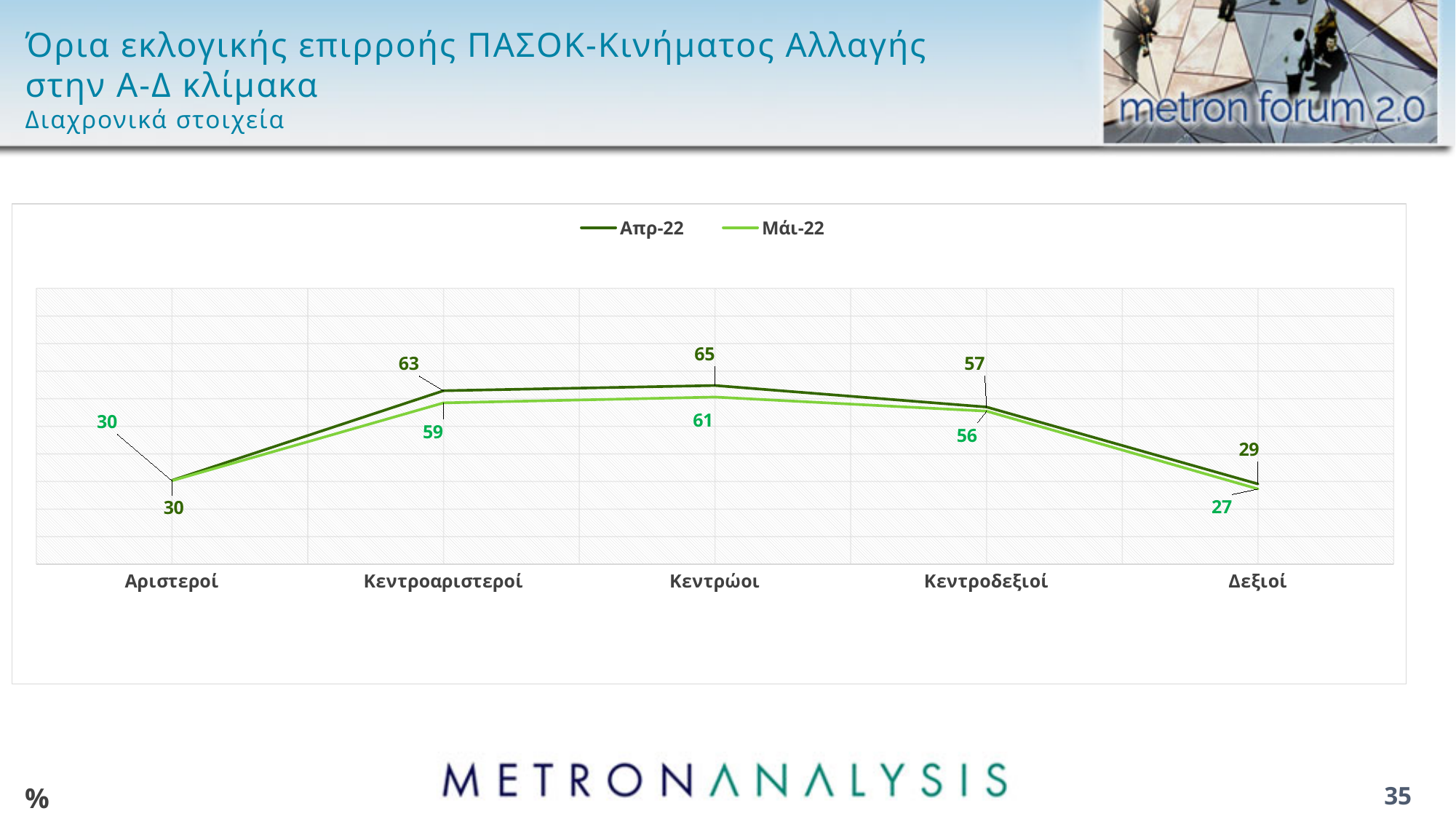
What is the difference between the Απρ-22 and Μάι-22 values for Κεντροαριστεροί? 4 How many categories are shown on the x axis? 5 What is the value for Κεντρώοι in the Απρ-22 series? 65 What type of chart is shown on the slide? line chart Which category has the highest value in the Απρ-22 series? Κεντρώοι What are the two series names shown in the legend? Απρ-22 and Μάι-22 Which category has the lowest value in the Μάι-22 series? Δεξιοί How many series does the legend list? 2 Which is larger for Κεντροδεξιοί: the Απρ-22 value or the Μάι-22 value? Απρ-22 What is the value for Δεξιοί in the Μάι-22 series? 27 What is the value for Κεντροαριστεροί in the Μάι-22 series? 59 Does the Μάι-22 series rise or fall from Κεντρώοι to Δεξιοί? fall